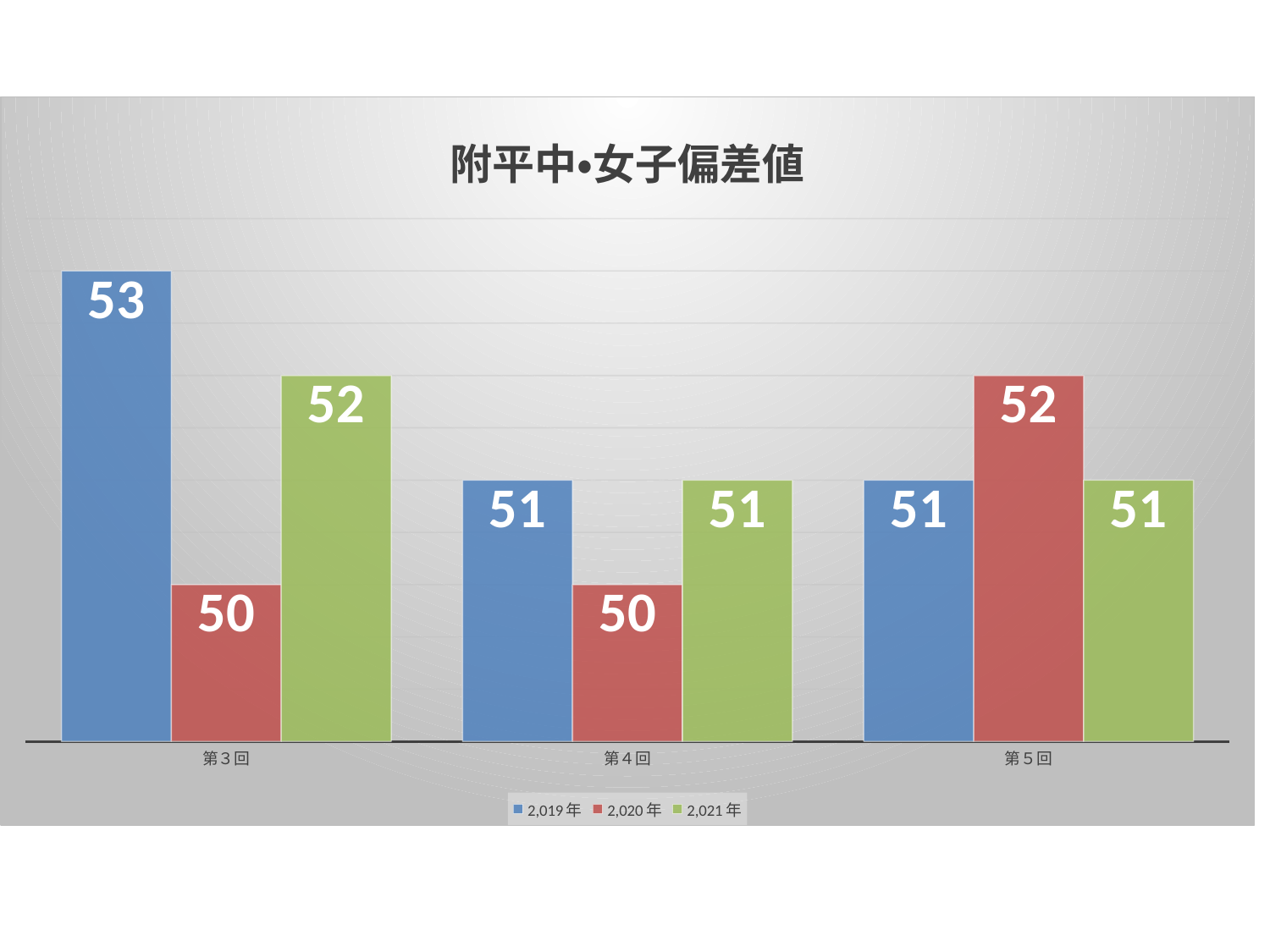
What is the title of the chart? 附平中•女子偏差値 What kind of chart is shown? bar chart How many series does the legend list? 3 Which is larger at 第5回, the 2,020年 value or the 2,021年 value? 2,020年 Which category has the highest value for the 2,020年 series? 第5回 What is the value for 2,020年 at 第5回? 52 What is the difference between the 2,019年 and 2,020年 values at 第3回? 3 Which category has the highest value for the 2,019年 series? 第3回 What is the value for 2,021年 at 第5回? 51 How many categories are shown on the x axis? 3 What is the value for 2,020年 at 第4回? 50 What is the value for 2,019年 at 第3回? 53